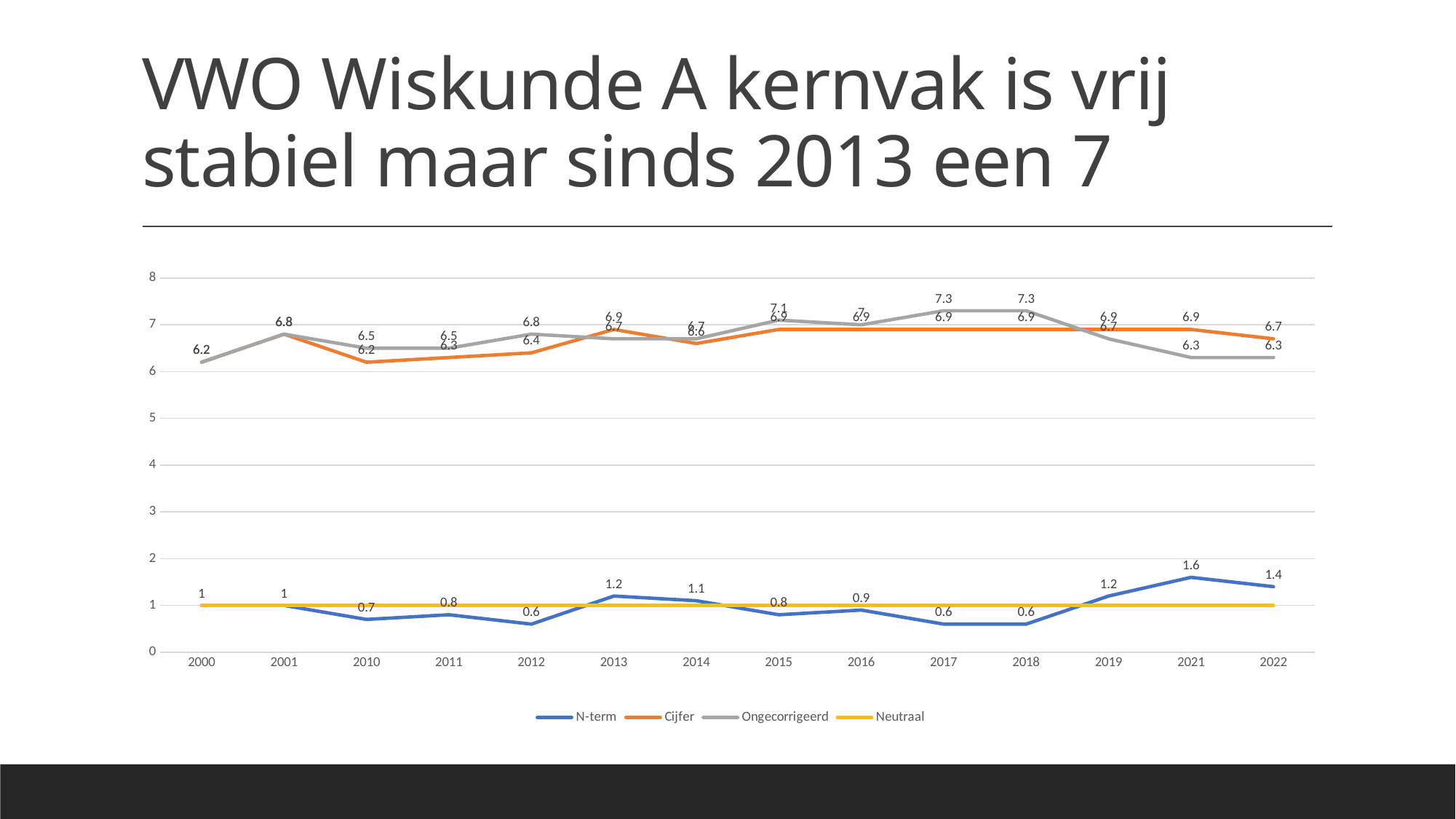
In which year is the N-term highest? 2021 What constant value does the Neutraal line show? 1 What kind of chart is shown on the slide? line chart Does the N-term rise or fall from 2018 to 2021? rise What is the Ongecorrigeerd value for 2017? 7.3 What colour is the Cijfer line in the legend? orange How many years are plotted along the x axis? 14 What is the N-term value for 2021? 1.6 What is the N-term value for 2012? 0.6 How many series does the legend list? 4 What is the difference between Cijfer and Ongecorrigeerd in 2022? 0.4 In 2021, which is larger: Cijfer or Ongecorrigeerd? Cijfer